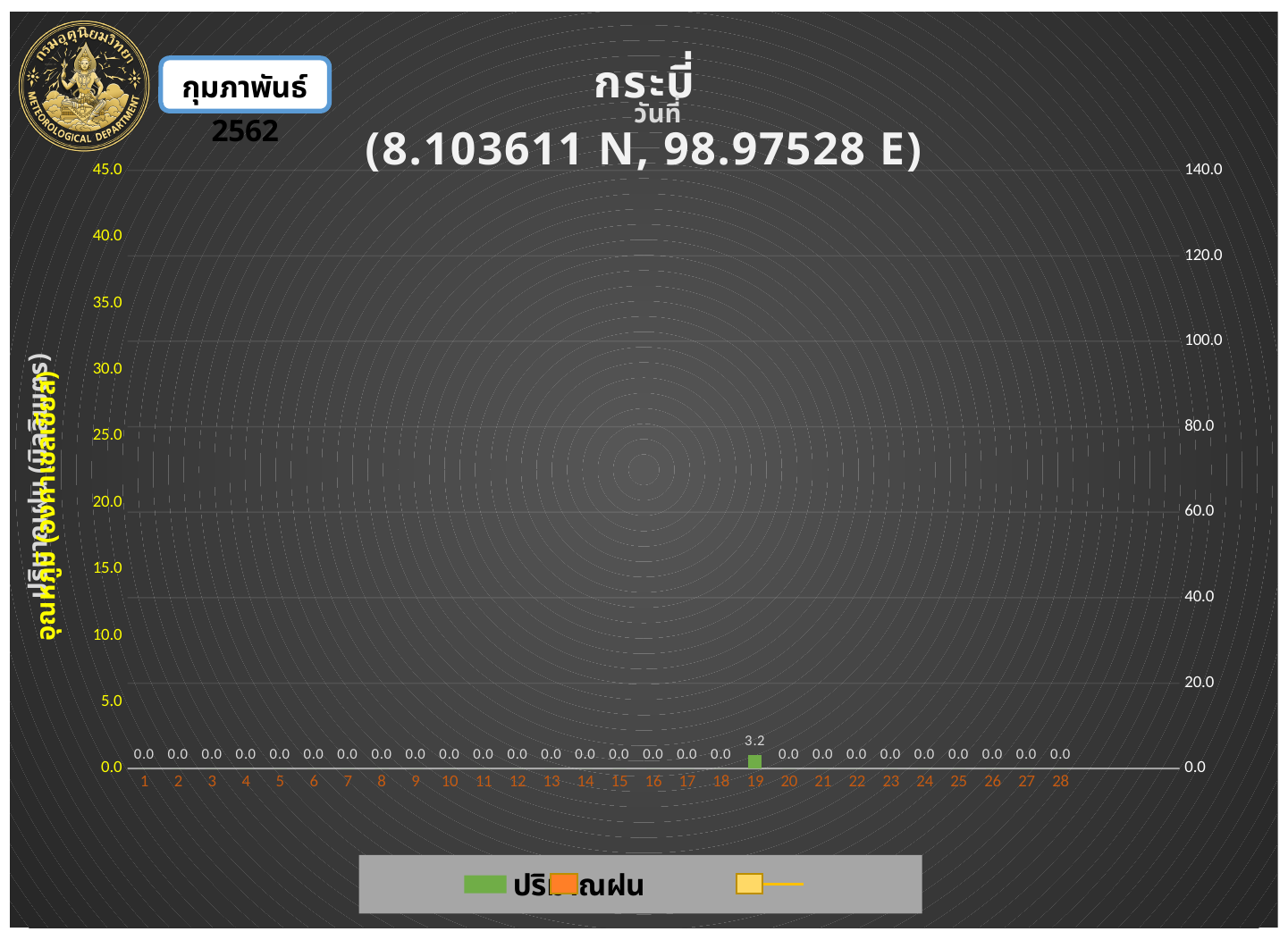
What is the difference between the value for day 19 and the value for day 18? 3.2 Which is larger, the value for day 19 or the value for day 20? day 19 Is the value for day 19 greater or less than 5.0 on the left axis? less How many days have a value other than 0.0? 1 What is the station name given in the chart title? กระบี่ What is the value shown for day 5? 0.0 What kind of chart is used to show the daily values? bar chart How many days are shown along the x axis? 28 What is the highest tick label on the right-hand axis? 140.0 What is the value shown for day 28? 0.0 Which day has the highest value on the chart? 19 What is the rainfall value shown for day 19? 3.2